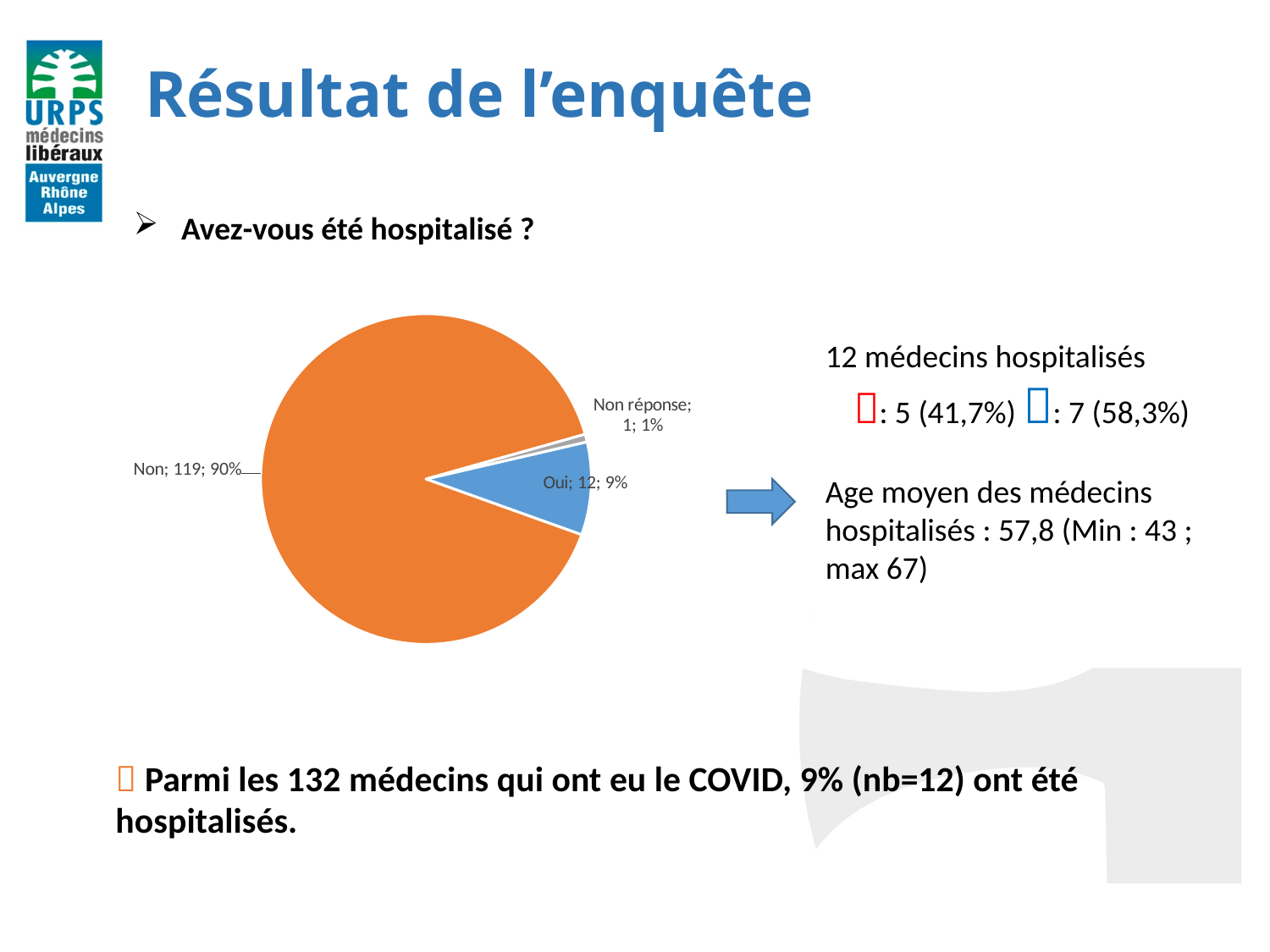
What percentage share does the 'Oui' slice represent? 9% What is the count for the 'Non' slice? 119 Which slice is the smallest? Non réponse What is the count for the 'Non réponse' slice? 1 What colour is the 'Oui' slice? blue Which is larger, the 'Oui' slice or the 'Non réponse' slice? Oui What kind of chart is shown on the slide? pie chart Which slice is the largest? Non What is the count for the 'Oui' slice? 12 What is the difference between the 'Non' count and the 'Oui' count? 107 How many slices does the pie chart have? 3 What percentage share does the 'Non' slice represent? 90%